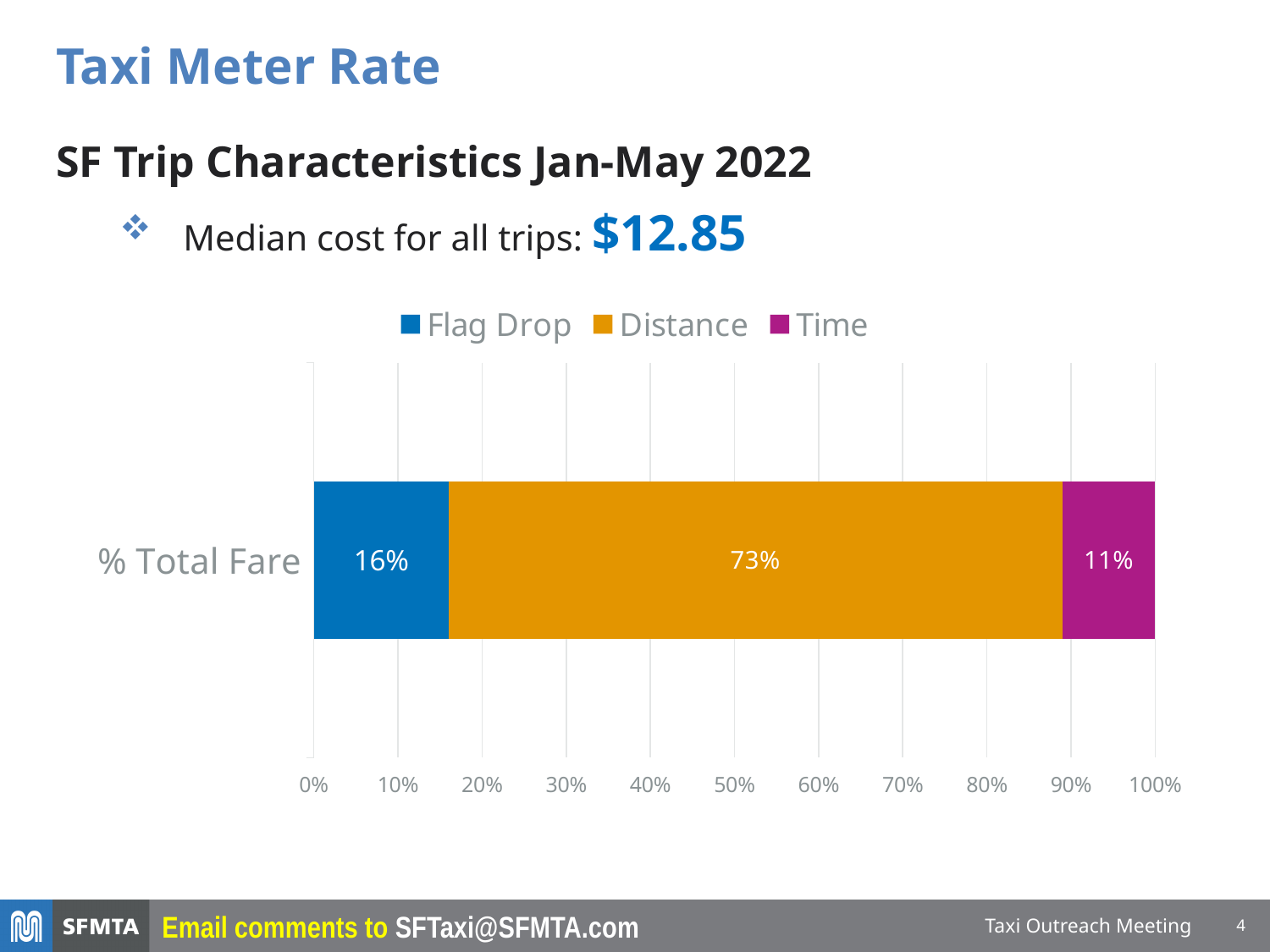
How many series does the legend list? 3 Which is larger, the Flag Drop share or the Time share of the total fare? Flag Drop What is the difference between the Flag Drop share and the Time share of the total fare? 5% What percentage of the total fare does Flag Drop account for? 16% What percentage of the total fare does Time account for? 11% Is the Distance share of the total fare greater or less than 50%? greater Which component makes up the largest share of the total fare? Distance What kind of chart is shown on the slide? Stacked bar chart What percentage of the total fare does Distance account for? 73% What is the difference between the Distance share and the Flag Drop share of the total fare? 57% Which component makes up the smallest share of the total fare? Time What is the total of the stacked bar for % Total Fare? 100%